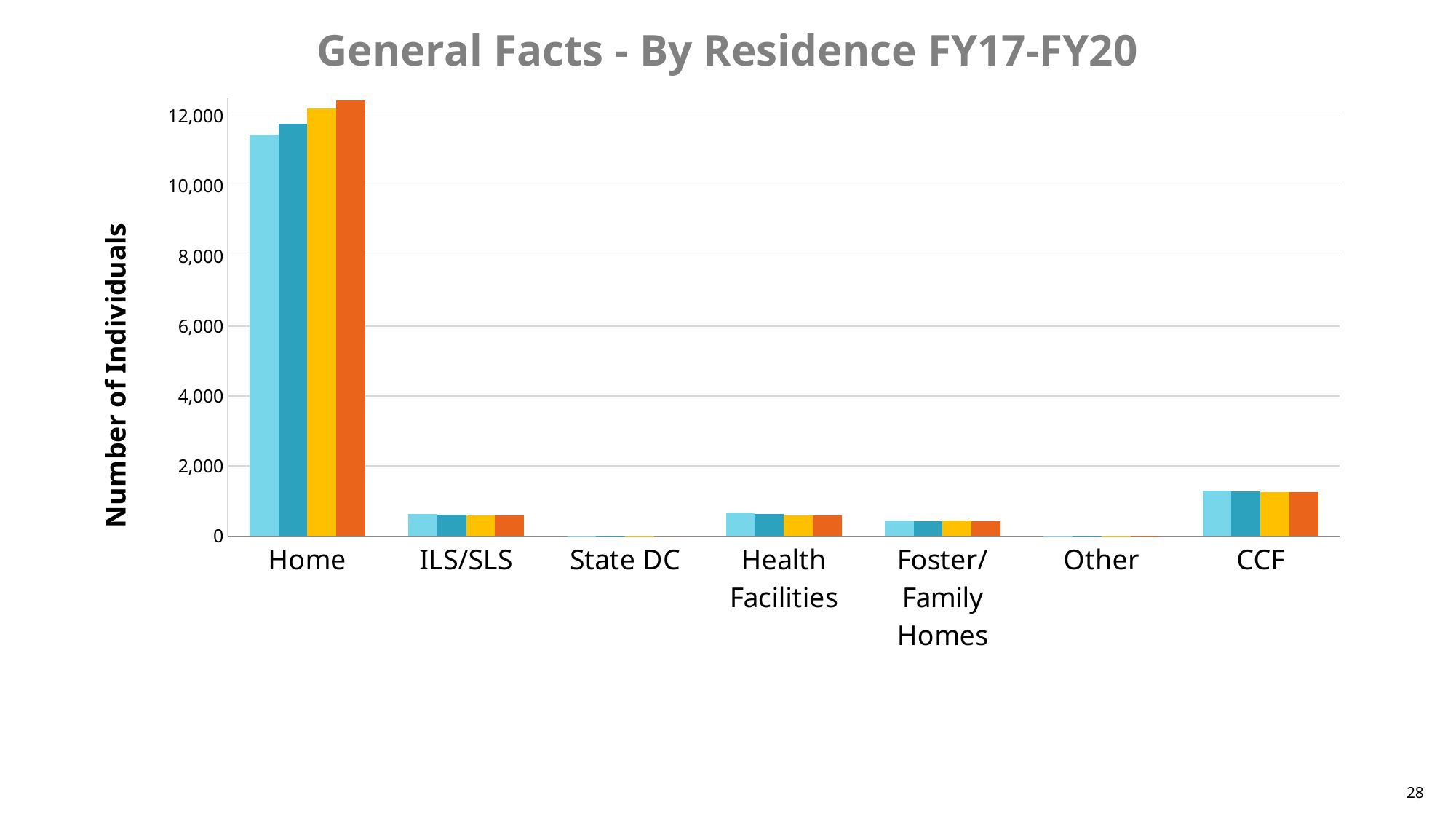
Which residence category has the highest number of individuals? Home Do the bars for Home rise or fall from left to right across the four fiscal years? rise What kind of chart is shown on the slide? bar chart What is the title of the chart? General Facts - By Residence FY17-FY20 Which has more individuals, CCF or ILS/SLS? CCF Is the value for ILS/SLS greater or less than 2,000? less Is the value for Home greater or less than 10,000? greater Which has more individuals, Home or CCF? Home Which has more individuals, Health Facilities or Foster/Family Homes? Health Facilities Is the value for CCF greater or less than 2,000? less What is the label on the y axis? Number of Individuals How many residence categories are shown on the x axis? 7